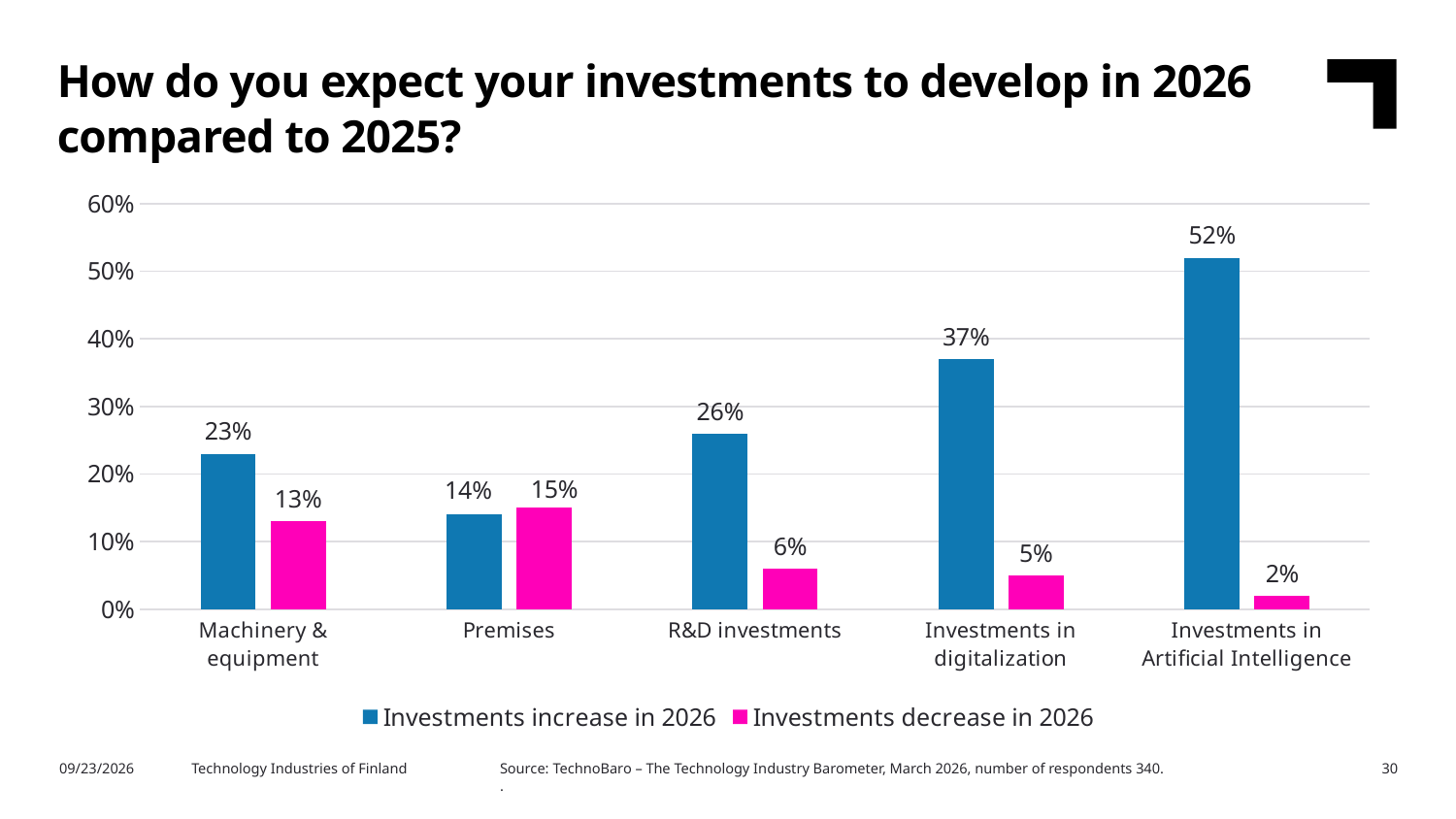
What kind of chart is shown on the slide? Bar chart Which category has the highest value for 'Investments increase in 2026'? Investments in Artificial Intelligence How many investment categories are shown on the x axis? 5 Which category has the lowest value for 'Investments decrease in 2026'? Investments in Artificial Intelligence What is the value for 'Investments increase in 2026' for R&D investments? 26% Is the 'Investments increase in 2026' value for Investments in digitalization greater or less than 30%? greater For Premises, which is larger: 'Investments increase in 2026' or 'Investments decrease in 2026'? Investments decrease in 2026 What percentage of respondents expect investments in Premises to decrease in 2026? 15% Which colour represents 'Investments decrease in 2026' in the chart? Pink (magenta) What is the difference between the 'Investments increase in 2026' and 'Investments decrease in 2026' values for Investments in digitalization? 32% How many series does the legend list? 2 What percentage of respondents expect investments in Artificial Intelligence to increase in 2026? 52%